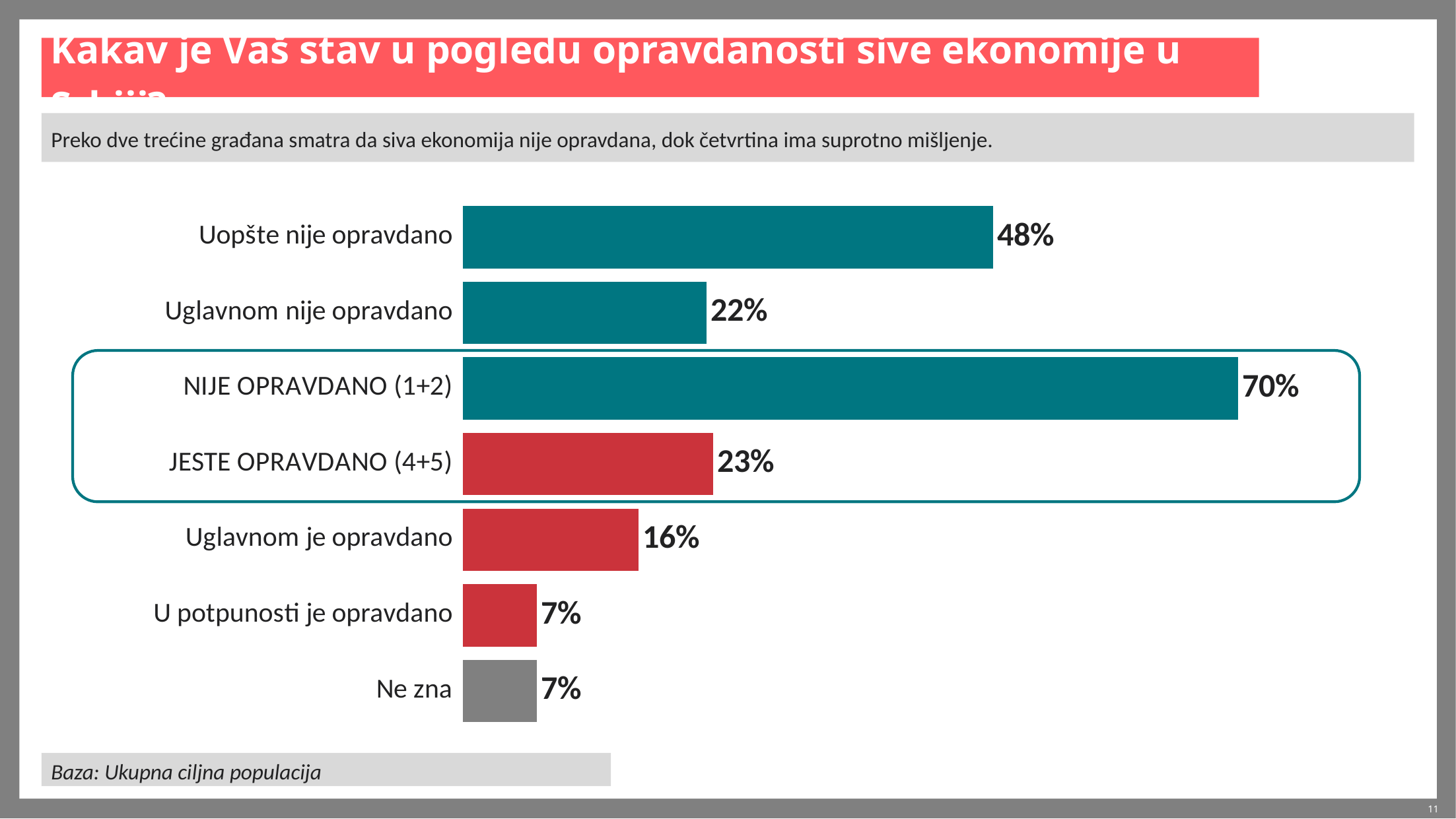
What colour is the bar for "Ne zna"? grey What is the value for "Uglavnom nije opravdano"? 22% What is the value for "Uglavnom je opravdano"? 16% Which category has the highest value? NIJE OPRAVDANO (1+2) What is the value for "JESTE OPRAVDANO (4+5)"? 23% What is the value for "Uopšte nije opravdano"? 48% Which is larger, "Uglavnom nije opravdano" or "Uglavnom je opravdano"? Uglavnom nije opravdano What is the value for "NIJE OPRAVDANO (1+2)"? 70% What is the difference between "NIJE OPRAVDANO (1+2)" and "JESTE OPRAVDANO (4+5)"? 47% How many categories are shown in the chart? 7 What is the value for "Ne zna"? 7% What kind of chart is shown on the slide? bar chart